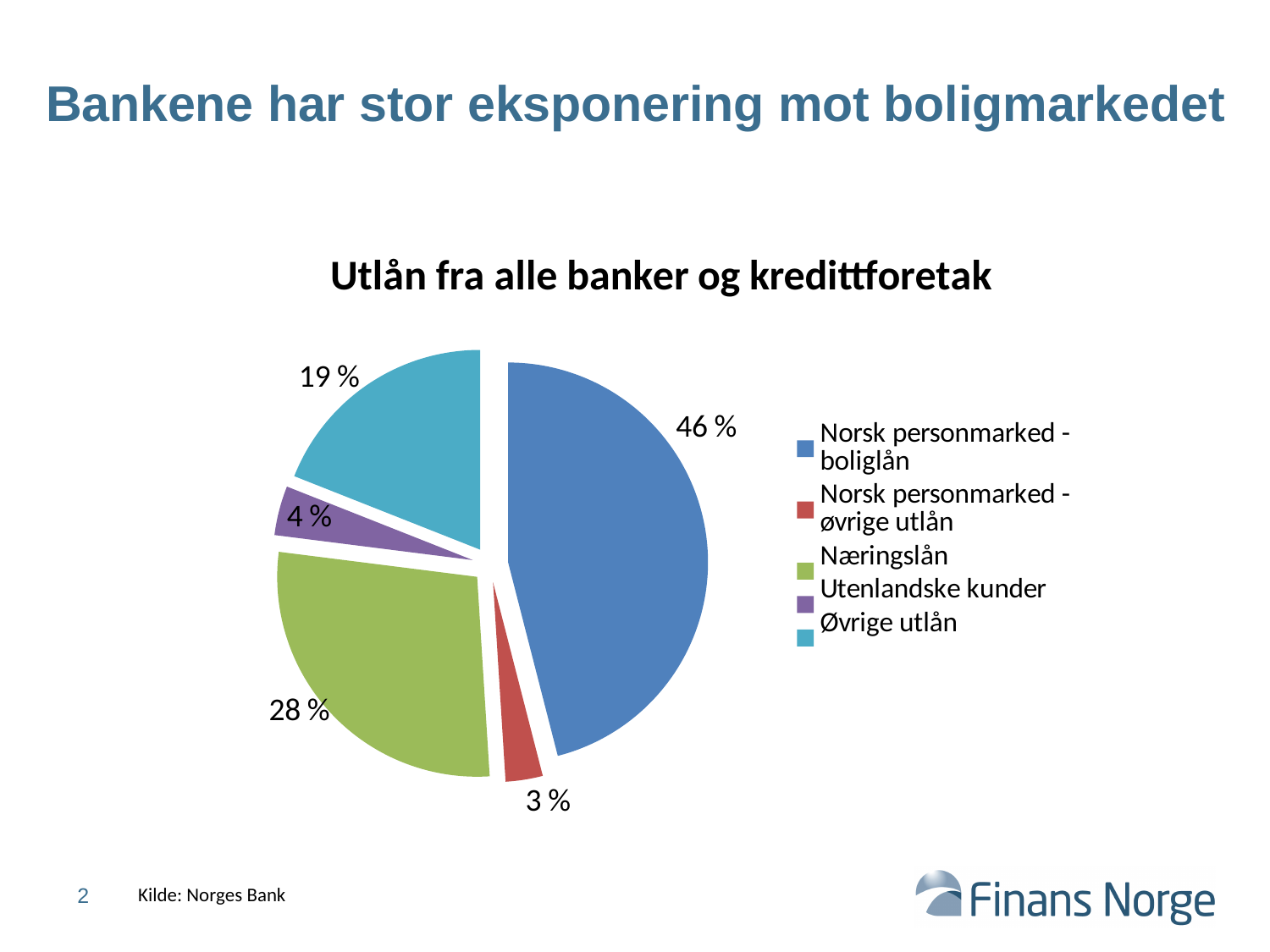
What share of the pie is Næringslån? 28 % Which category has the smallest slice of the pie? Norsk personmarked - øvrige utlån What is the difference in percentage points between Norsk personmarked - boliglån and Næringslån? 18 percentage points What share of the pie is Norsk personmarked - boliglån? 46 % What is the title of the chart? Utlån fra alle banker og kredittforetak What share of the pie is Norsk personmarked - øvrige utlån? 3 % Which is larger, the share for Øvrige utlån or the share for Utenlandske kunder? Øvrige utlån What type of chart is shown on the slide? Pie chart How many categories does the pie chart show? 5 Which category has the largest slice of the pie? Norsk personmarked - boliglån